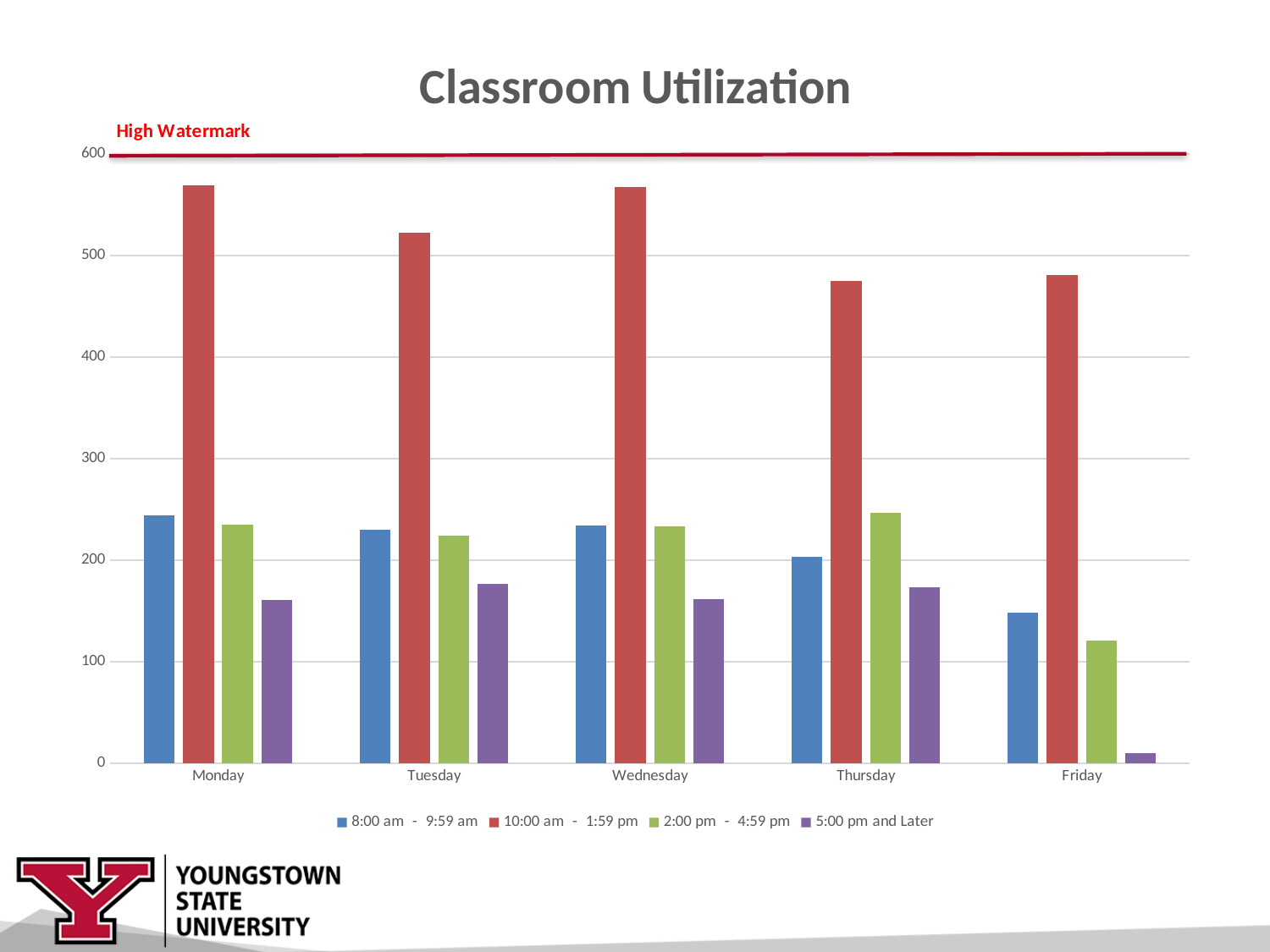
How many series does the chart's legend list? 4 Which day has the lowest value for 5:00 pm and Later? Friday How many days are shown on the x axis of the chart? 5 What kind of chart is shown on the slide? bar chart What is the label of the red horizontal line drawn at the top of the chart? High Watermark Is the value for 10:00 am - 1:59 pm on Thursday greater or less than 500? less On Friday, which is larger: the value for 10:00 am - 1:59 pm or the value for 2:00 pm - 4:59 pm? 10:00 am - 1:59 pm Is the value for 10:00 am - 1:59 pm on Monday greater or less than 500? greater Which day has the lowest value for 8:00 am - 9:59 am? Friday Is the value for 8:00 am - 9:59 am on Friday greater or less than 200? less On Thursday, which is larger: the value for 8:00 am - 9:59 am or the value for 2:00 pm - 4:59 pm? 2:00 pm - 4:59 pm